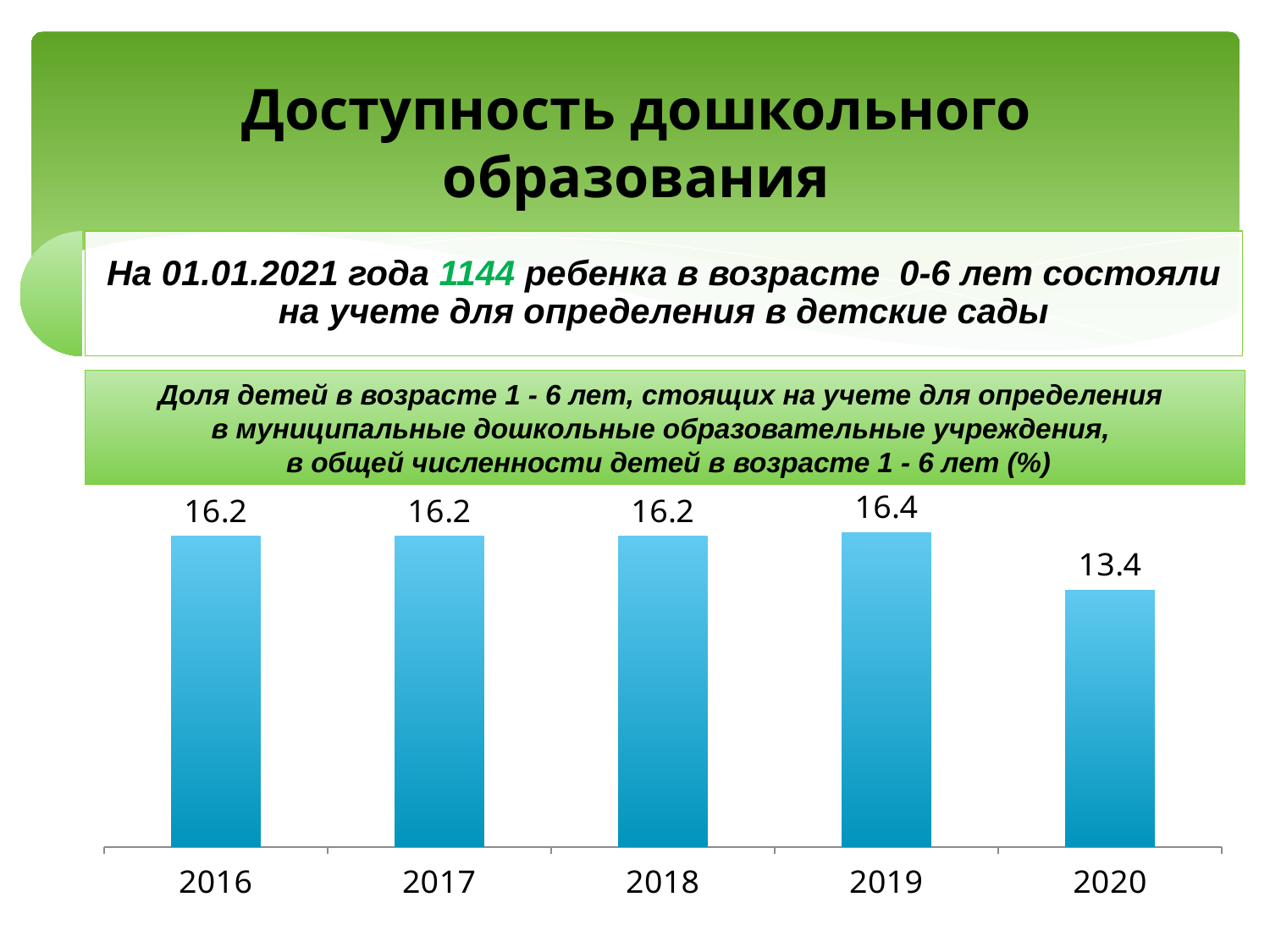
What is the value for 2020? 13.4 How many years share the value 16.2? 3 What is the difference between the values for 2019 and 2018? 0.2 Which year has the lowest value? 2020 What is the value for 2016? 16.2 What is the difference between the values for 2019 and 2020? 3.0 How many years are shown on the chart? 5 Which year has the highest value? 2019 What kind of chart is shown on the slide? bar chart What is the value for 2019? 16.4 Which is larger, the value for 2018 or the value for 2020? 2018 Does the value rise or fall from 2019 to 2020? fall